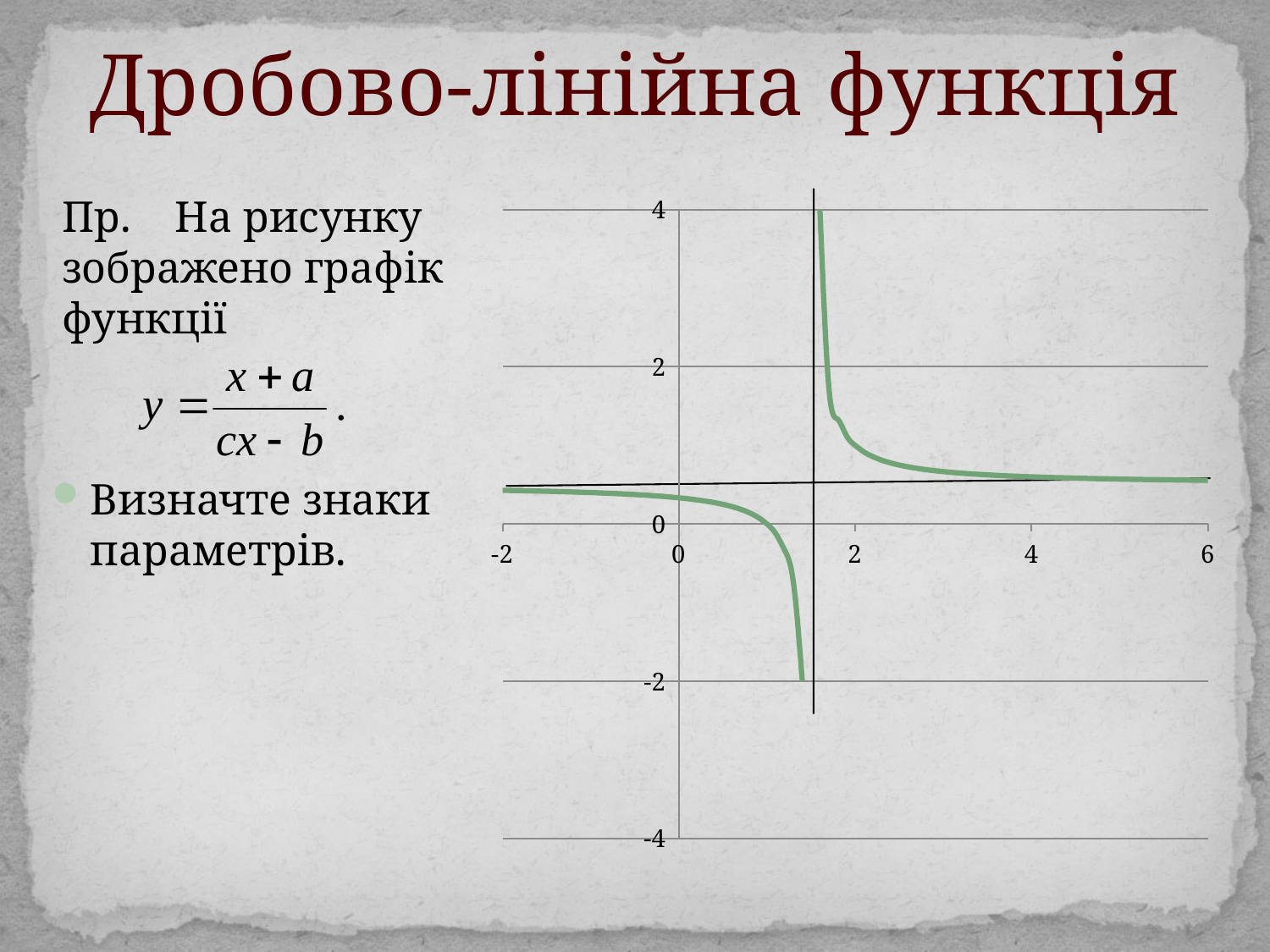
Does the curve rise or fall as x increases from 2 to 6? fall Is the value of the curve at x = 4 greater or less than 2? less Does the curve rise or fall as x increases from -2 to 1? fall What is the highest value labelled on the y axis of the chart? 4 What is the lowest value labelled on the x axis of the chart? -2 Is the value of the curve at x = 2 greater or less than 4? less What kind of chart is shown on the slide? line chart What colour is the plotted curve on the chart? green Is the value of the curve at x = 6 greater or less than 0? greater